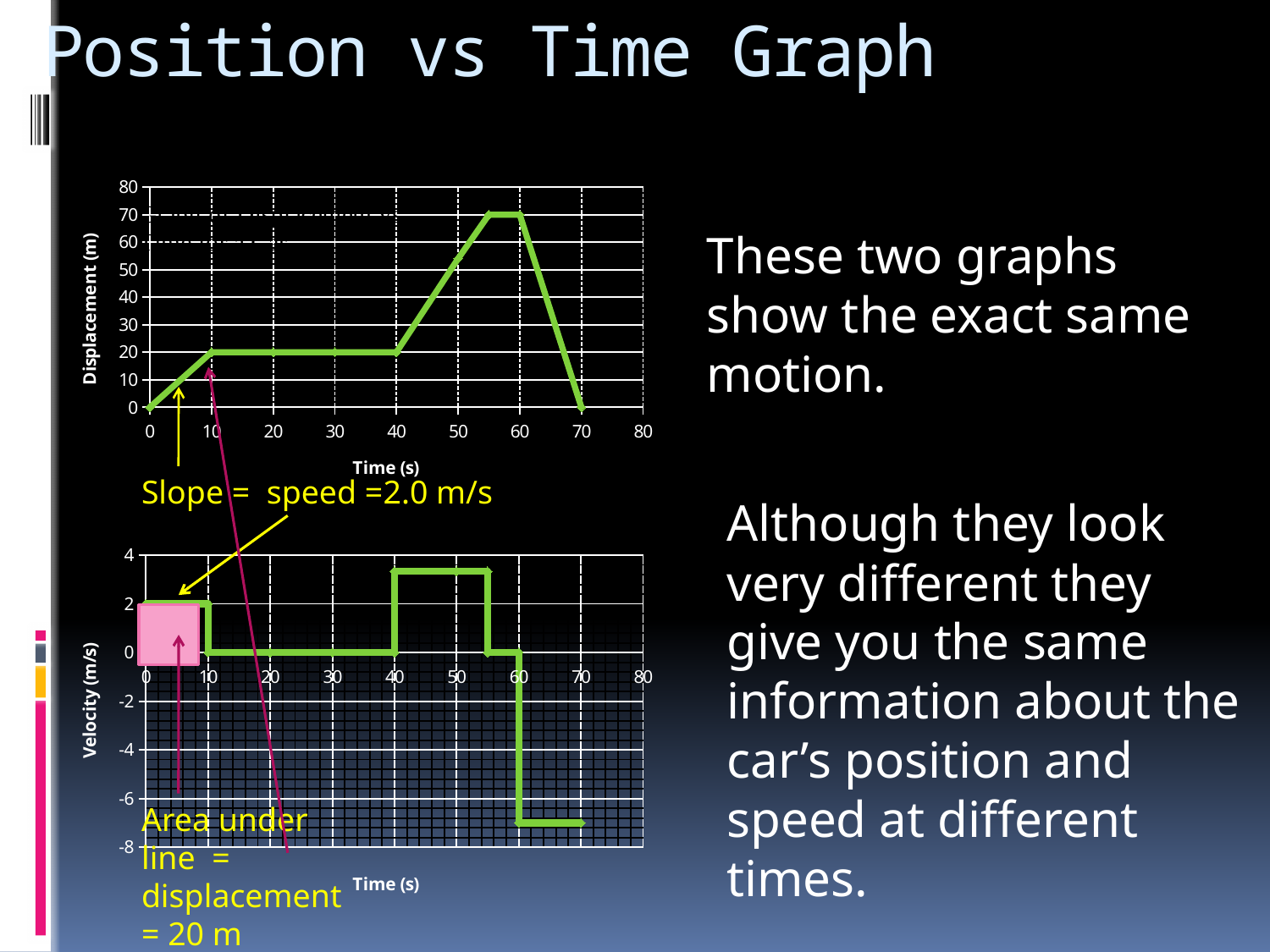
In the top Displacement (m) chart, does the displacement rise or fall between 40 s and 55 s? rise In the top Displacement (m) chart, what is the displacement at 10 s? 20 In the bottom Velocity (m/s) chart, what is the velocity between 0 s and 10 s? 2 What kind of chart is the top chart (Displacement vs Time)? line chart In the bottom Velocity (m/s) chart, is the velocity between 60 s and 70 s greater or less than -6? less In the bottom Velocity (m/s) chart, what is the velocity between 10 s and 40 s? 0 In the top Displacement (m) chart, what is the displacement at 70 s? 0 In the top Displacement (m) chart, is the displacement larger at 40 s or at 60 s? 60 s In the top Displacement (m) chart, what is the maximum displacement reached? 70 In the top Displacement (m) chart, does the displacement rise or fall between 60 s and 70 s? fall What is the y-axis label of the top chart? Displacement (m) In the bottom Velocity (m/s) chart, is the velocity between 40 s and 55 s greater or less than 2? greater